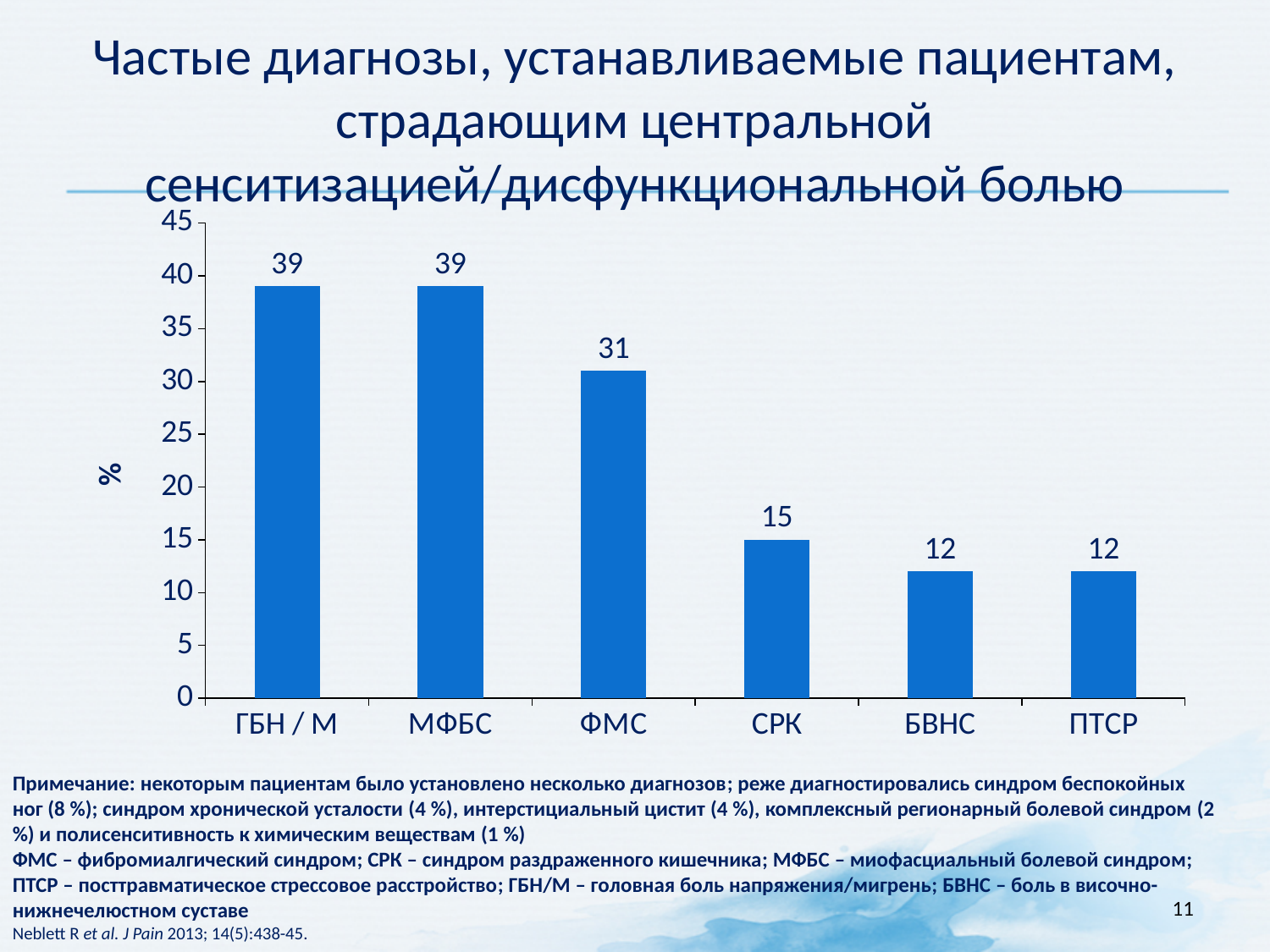
What is the value for СРК? 15 What is the difference between the values for МФБС and ФМС? 8 Which is larger, the value for ФМС or the value for СРК? ФМС What is the value for ФМС? 31 What is the difference between the values for СРК and БВНС? 3 How many categories are shown on the x axis? 6 Is the value for ФМС greater or less than 30? greater What is the value for ПТСР? 12 What kind of chart is shown on the slide? bar chart Which category has the lowest value? БВНС and ПТСР (both 12) What is the label of the y axis? % Which categories share the highest value? ГБН / М and МФБС